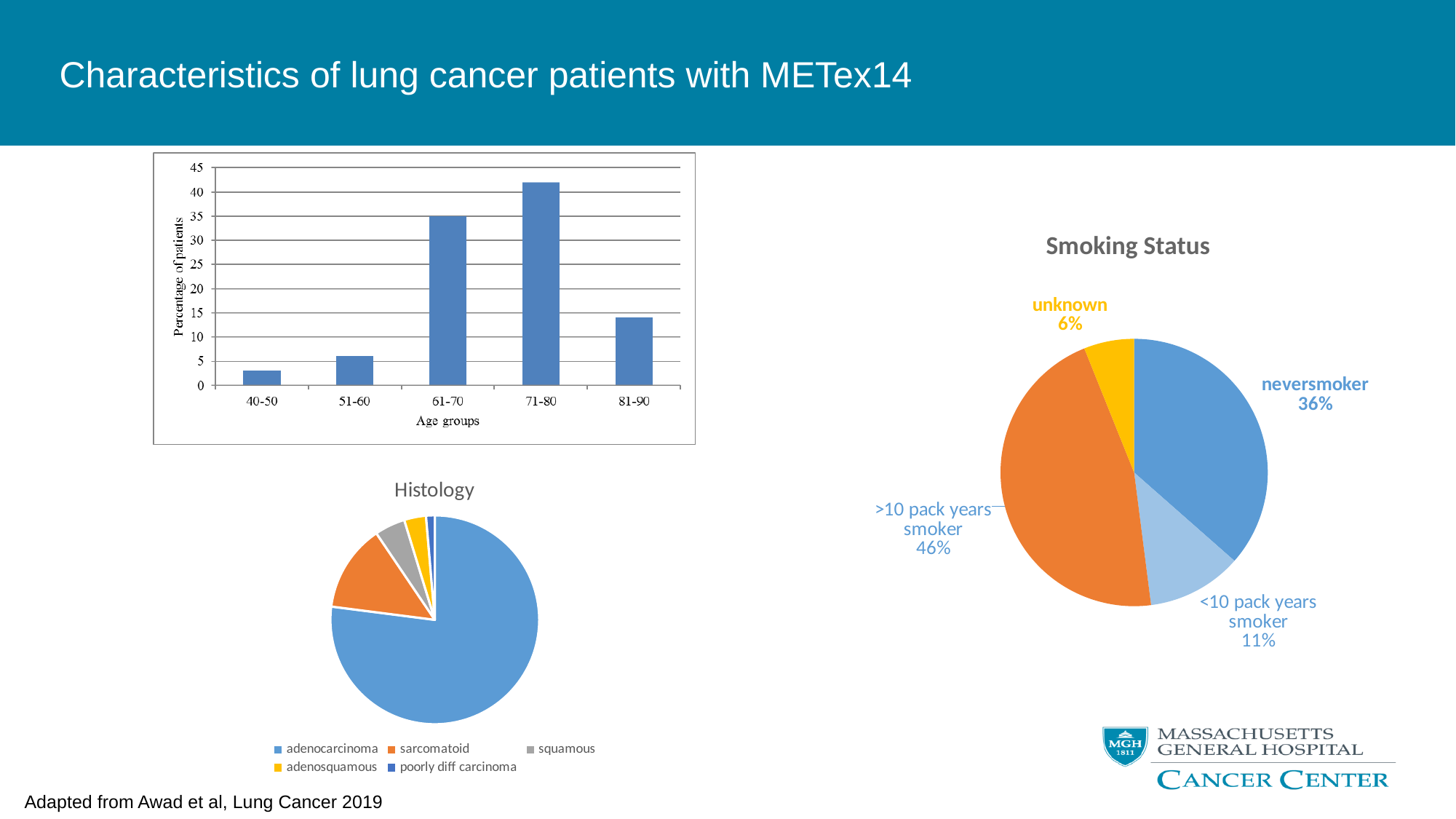
In the Histology pie chart, how many categories does the legend list? 5 In the Smoking Status pie chart, what percentage of patients are never smokers? 36% In the age groups bar chart, how many age groups are shown on the x axis? 5 In the Smoking Status pie chart, what percentage of patients are >10 pack years smokers? 46% In the Smoking Status pie chart, what is the difference between the >10 pack years smoker share and the never smoker share? 10% In the age groups bar chart, which age group has the lowest percentage of patients? 40-50 In the age groups bar chart, which age group has the highest percentage of patients? 71-80 In the age groups bar chart, is the value for 71-80 greater or less than 40? greater What kind of chart is the top-left chart showing age groups? bar chart In the Histology pie chart, which category has the largest slice? adenocarcinoma In the age groups bar chart, which has a higher percentage of patients, 61-70 or 81-90? 61-70